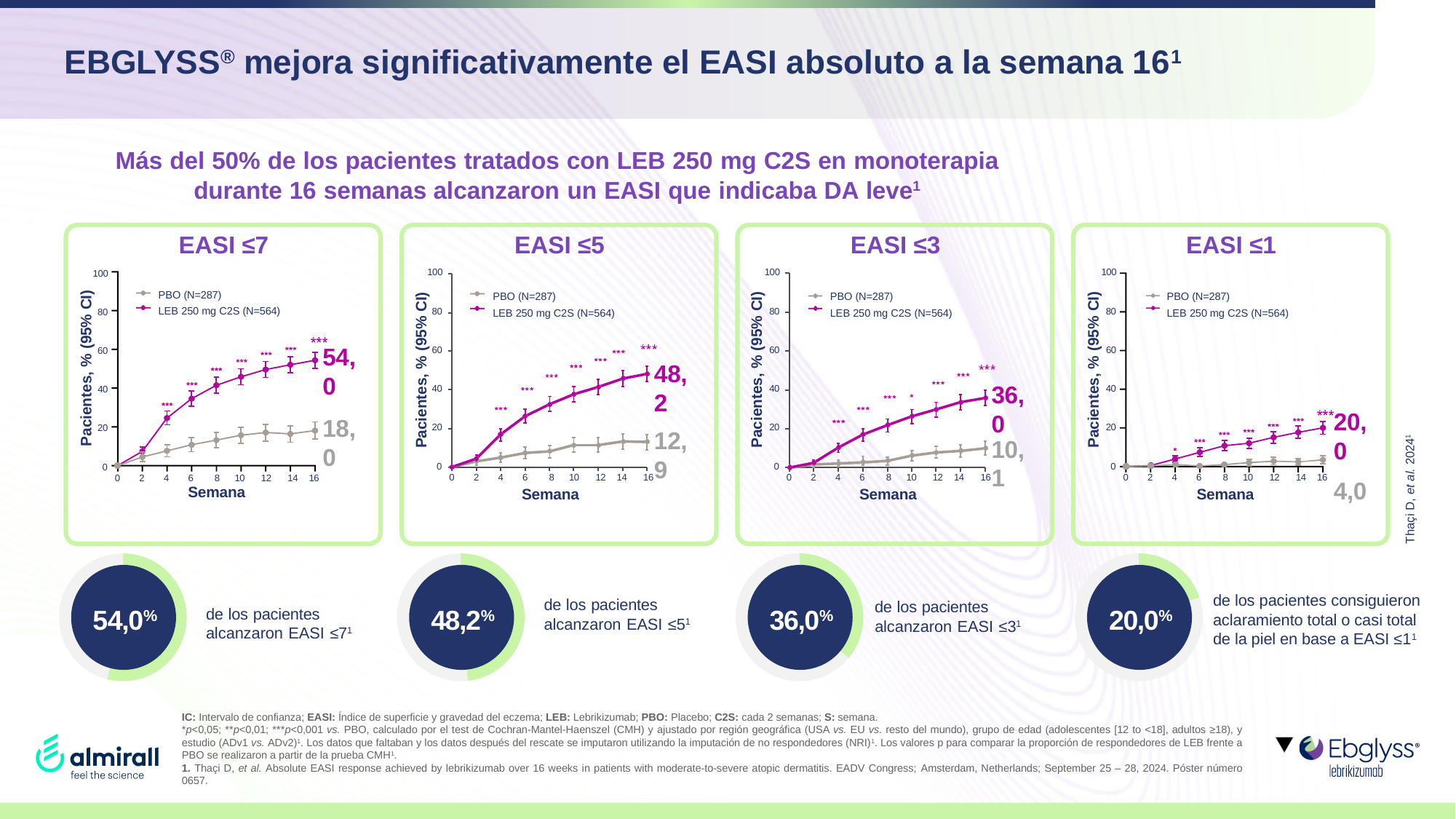
In the EASI ≤5 chart, is the value for LEB 250 mg C2S at week 8 greater or less than 20? greater How many series does the legend of the EASI ≤7 chart list? 2 What kind of chart is the EASI ≤3 chart? Line chart In the EASI ≤1 chart, what is the value for LEB 250 mg C2S at week 16? 20,0 In the EASI ≤7 chart, does the LEB 250 mg C2S series rise or fall from week 0 to week 16? Rise In the EASI ≤3 chart, what is the value for PBO at week 16? 10,1 In the EASI ≤3 chart, which series has the higher value at week 16, LEB 250 mg C2S or PBO? LEB 250 mg C2S In the EASI ≤7 chart, what is the value for LEB 250 mg C2S at week 16? 54,0 In the EASI ≤1 chart, what is the difference between LEB 250 mg C2S and PBO at week 16? 16,0 What is the x-axis label of the EASI ≤5 chart? Semana In the EASI ≤7 chart, what is the value for PBO at week 16? 18,0 In the EASI ≤5 chart, what is the value for LEB 250 mg C2S at week 16? 48,2